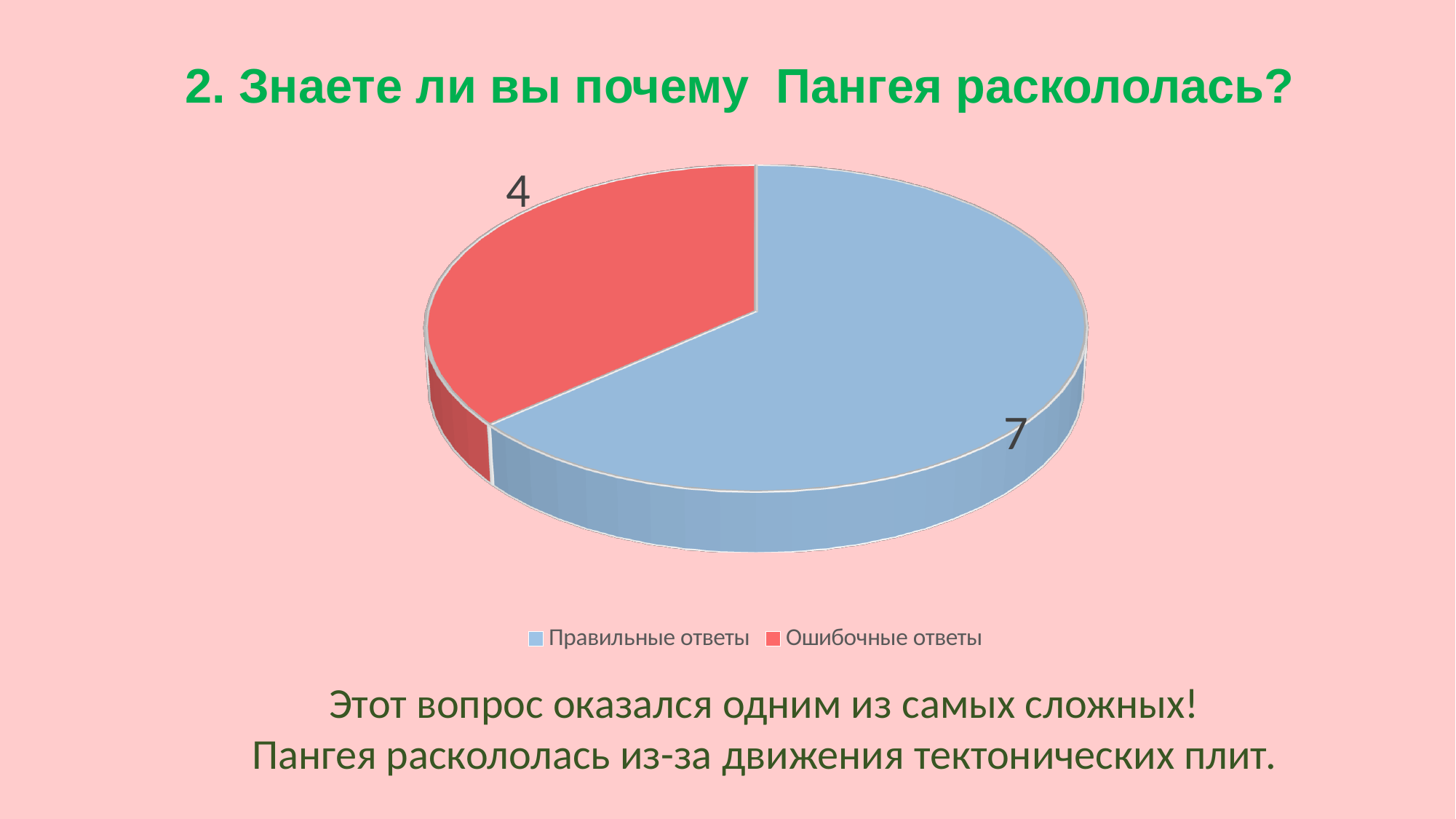
What is the value for Ошибочные ответы? 4 Which category has the largest slice of the pie? Правильные ответы What share of the total do Правильные ответы make up? 7 out of 11 How many entries does the legend list? 2 What colour is the slice for Ошибочные ответы? red How many slices does the pie chart have? 2 What is the difference between the values for Правильные ответы and Ошибочные ответы? 3 What is the total of all slices in the pie chart? 11 What type of chart is shown on the slide? pie chart What is the value for Правильные ответы? 7 Which category has the smallest slice of the pie? Ошибочные ответы Which is larger: Правильные ответы or Ошибочные ответы? Правильные ответы